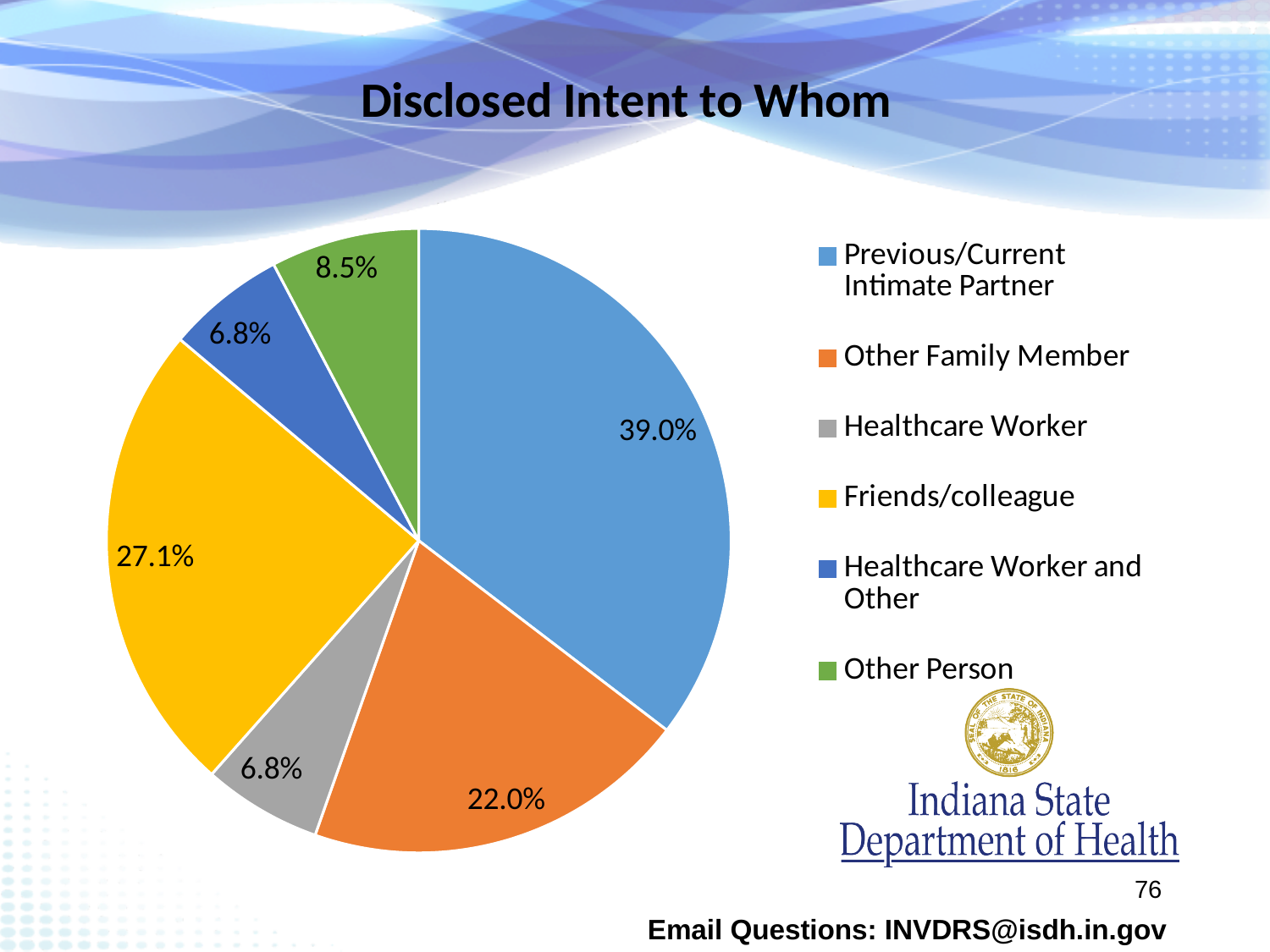
How many categories does the legend list? 6 Which is larger, Friends/colleague or Other Family Member? Friends/colleague What is the difference in percentage points between Previous/Current Intimate Partner and Other Family Member? 17.0% What is the title of the chart? Disclosed Intent to Whom What share of the pie is Healthcare Worker? 6.8% What kind of chart is shown on the slide? pie chart What colour is the Friends/colleague slice? yellow Which category has the largest slice of the pie? Previous/Current Intimate Partner What share of the pie is Other Family Member? 22.0% What share of the pie is Other Person? 8.5%